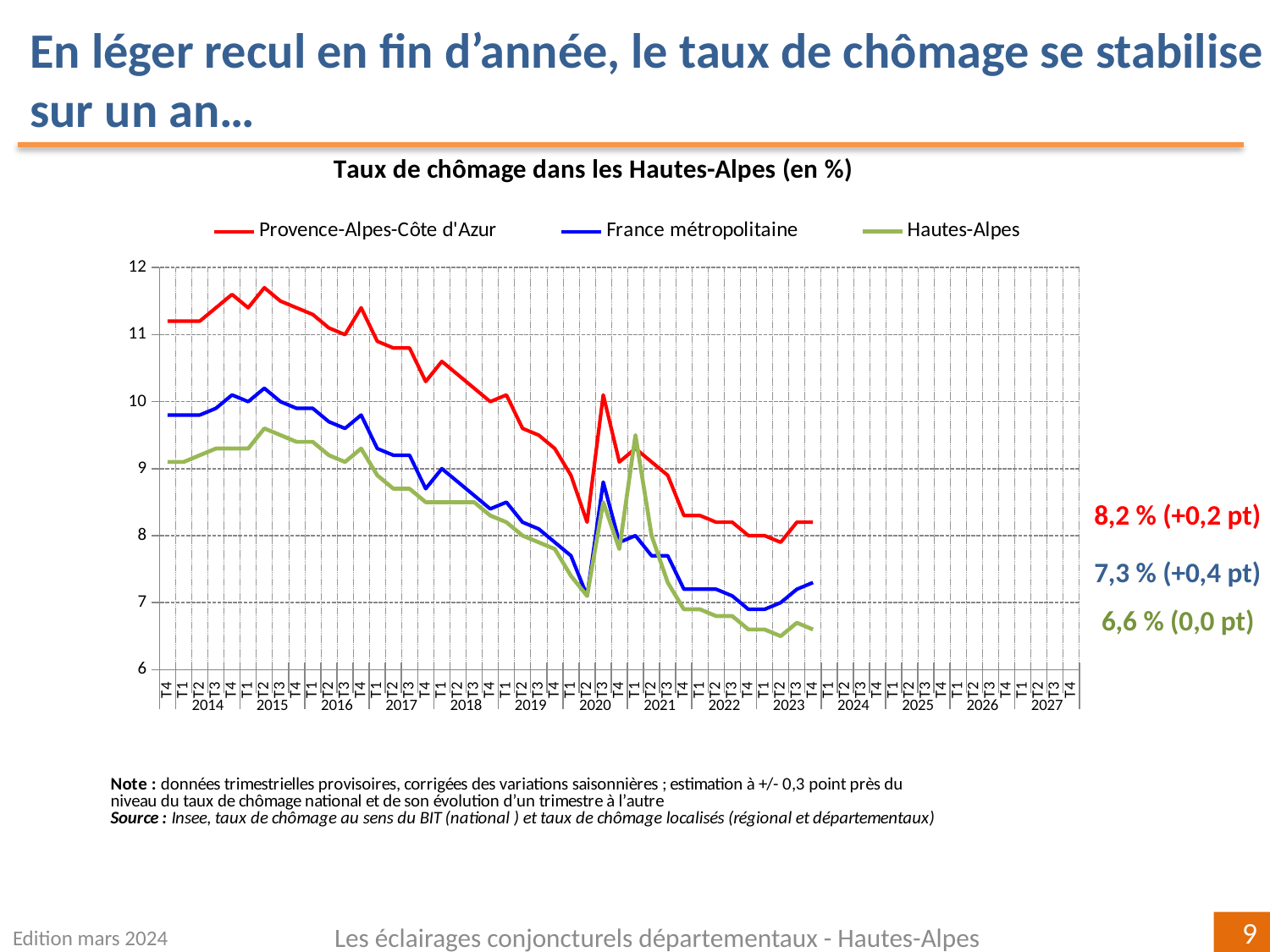
What change over one year is annotated for France métropolitaine? +0,4 pt Is the value for Provence-Alpes-Côte d'Azur in T2 2015 greater or less than 11? greater What kind of chart is shown on the slide? line chart What is the title of the chart? Taux de chômage dans les Hautes-Alpes (en %) How many series does the legend list? 3 Overall, do the unemployment rates rise or fall between 2014 and 2023? fall What is the latest unemployment rate shown for France métropolitaine? 7,3 % Which series has the lowest value at the end of 2023? Hautes-Alpes What is the difference between the latest rates for Provence-Alpes-Côte d'Azur and Hautes-Alpes? 1,6 points Which series has the highest value at the end of 2023? Provence-Alpes-Côte d'Azur What is the latest unemployment rate shown for Hautes-Alpes? 6,6 % What is the latest unemployment rate shown for Provence-Alpes-Côte d'Azur? 8,2 %